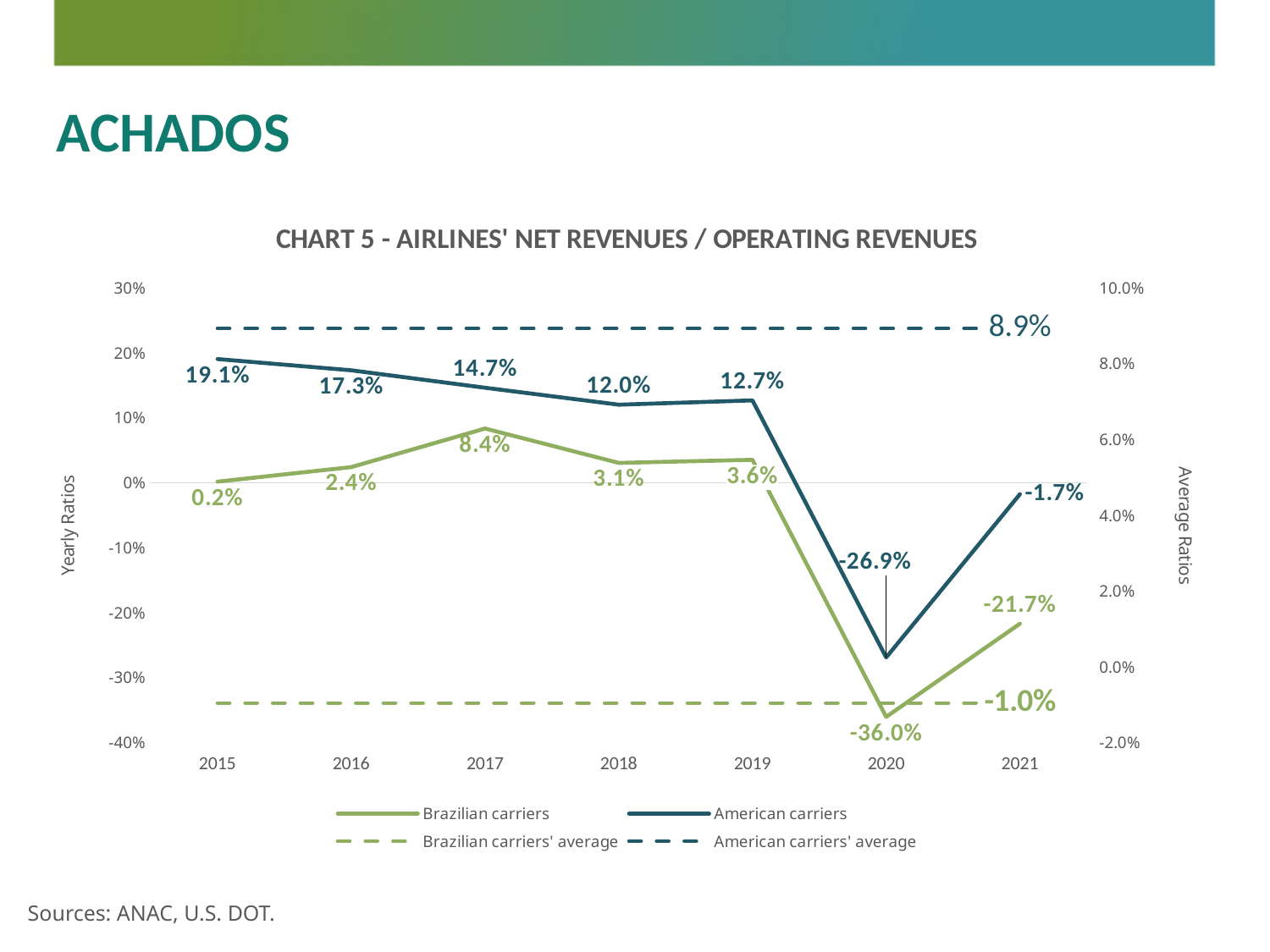
How many years are plotted on the x axis? 7 Do the values for American carriers rise or fall from 2015 to 2018? Fall What is the value for Brazilian carriers in 2017? 8.4% What is the value for American carriers in 2015? 19.1% What is the American carriers' average shown by the dashed line? 8.9% In which year is the value for American carriers lowest? 2020 What is the value for Brazilian carriers in 2020? -36.0% Which series has the larger value in 2021, Brazilian carriers or American carriers? American carriers How many series does the legend list? 4 What kind of chart is this? Line chart In which year is the value for Brazilian carriers highest? 2017 What is the difference between the American carriers' value and the Brazilian carriers' value in 2018? 8.9%